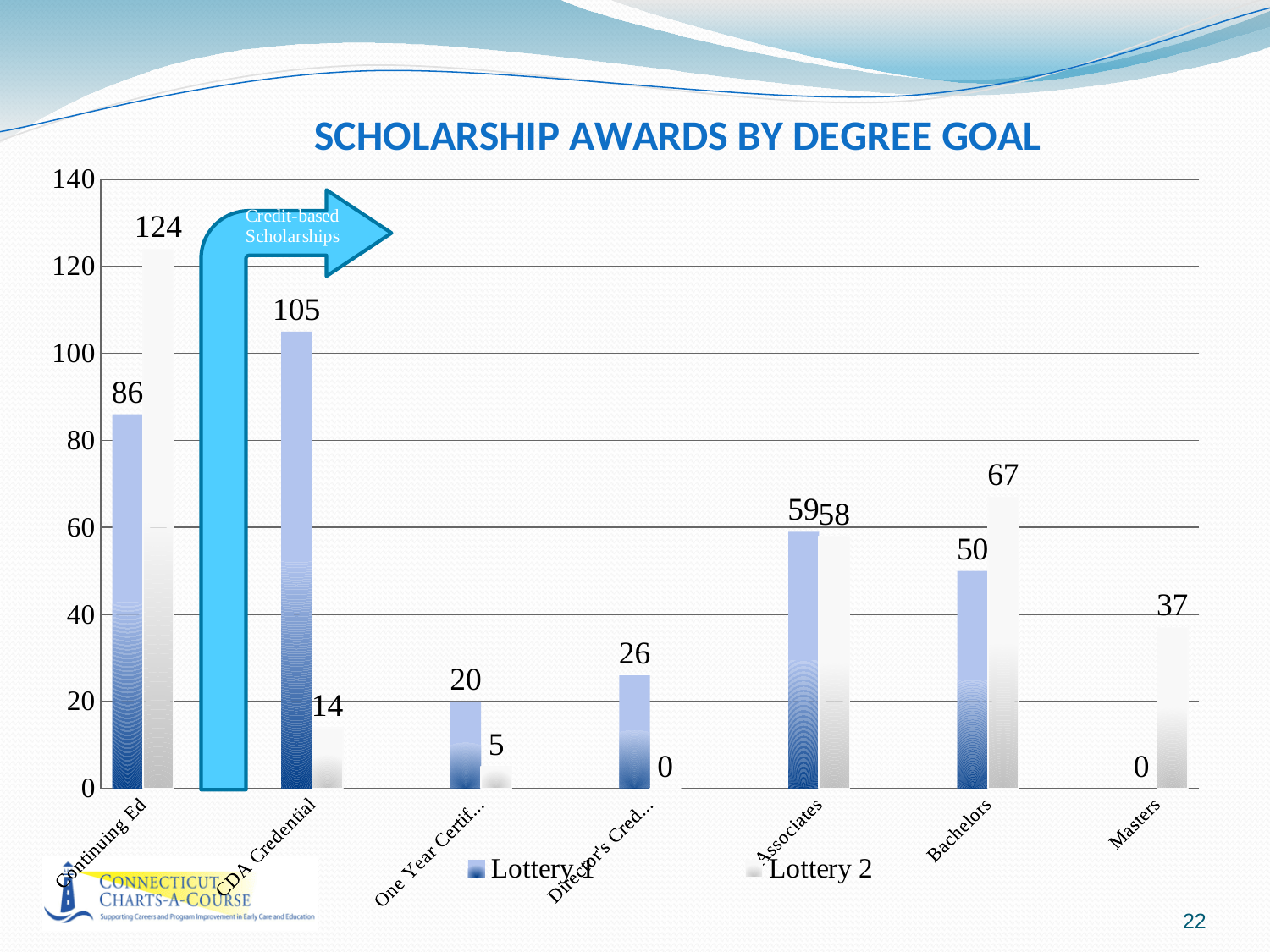
Which degree goal has the highest Lottery 1 value? CDA Credential What is the Lottery 2 value for Masters? 37 For Bachelors, which series has the larger value, Lottery 1 or Lottery 2? Lottery 2 What is the difference between the Lottery 2 and Lottery 1 values for Continuing Ed? 38 What is the Lottery 1 value for CDA Credential? 105 How many series does the legend list? 2 What is the Lottery 1 value for Continuing Ed? 86 What is the Lottery 2 value for Continuing Ed? 124 What kind of chart is shown on the slide? Bar chart Which degree goal has the lowest Lottery 1 value? Masters Which degree goal has the highest Lottery 2 value? Continuing Ed What is the difference between the Lottery 1 and Lottery 2 values for CDA Credential? 91